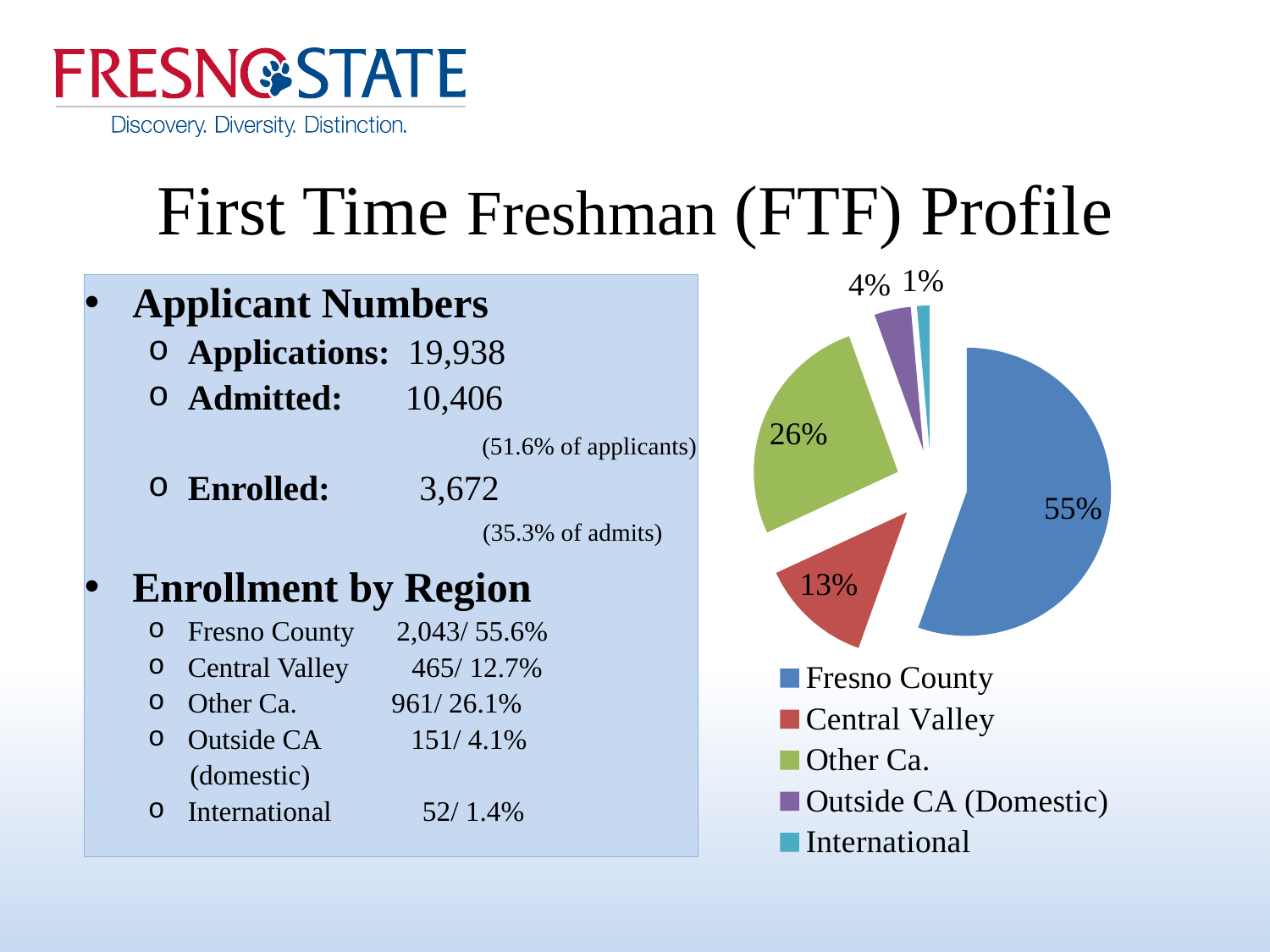
What colour is the Fresno County slice in the pie chart? blue Which region has the smallest slice of the pie? International Which slice is larger, Central Valley or Other Ca.? Other Ca. What share of the pie does Other Ca. represent? 26% What share of the pie does Outside CA (Domestic) represent? 4% What share of the pie does Central Valley represent? 13% What share of the pie does International represent? 1% How many slices does the pie chart have? 5 What kind of chart is shown on the slide? pie chart What share of the pie does Fresno County represent? 55% What is the difference in percentage points between the Fresno County slice and the Other Ca. slice? 29% Which region has the largest slice of the pie? Fresno County